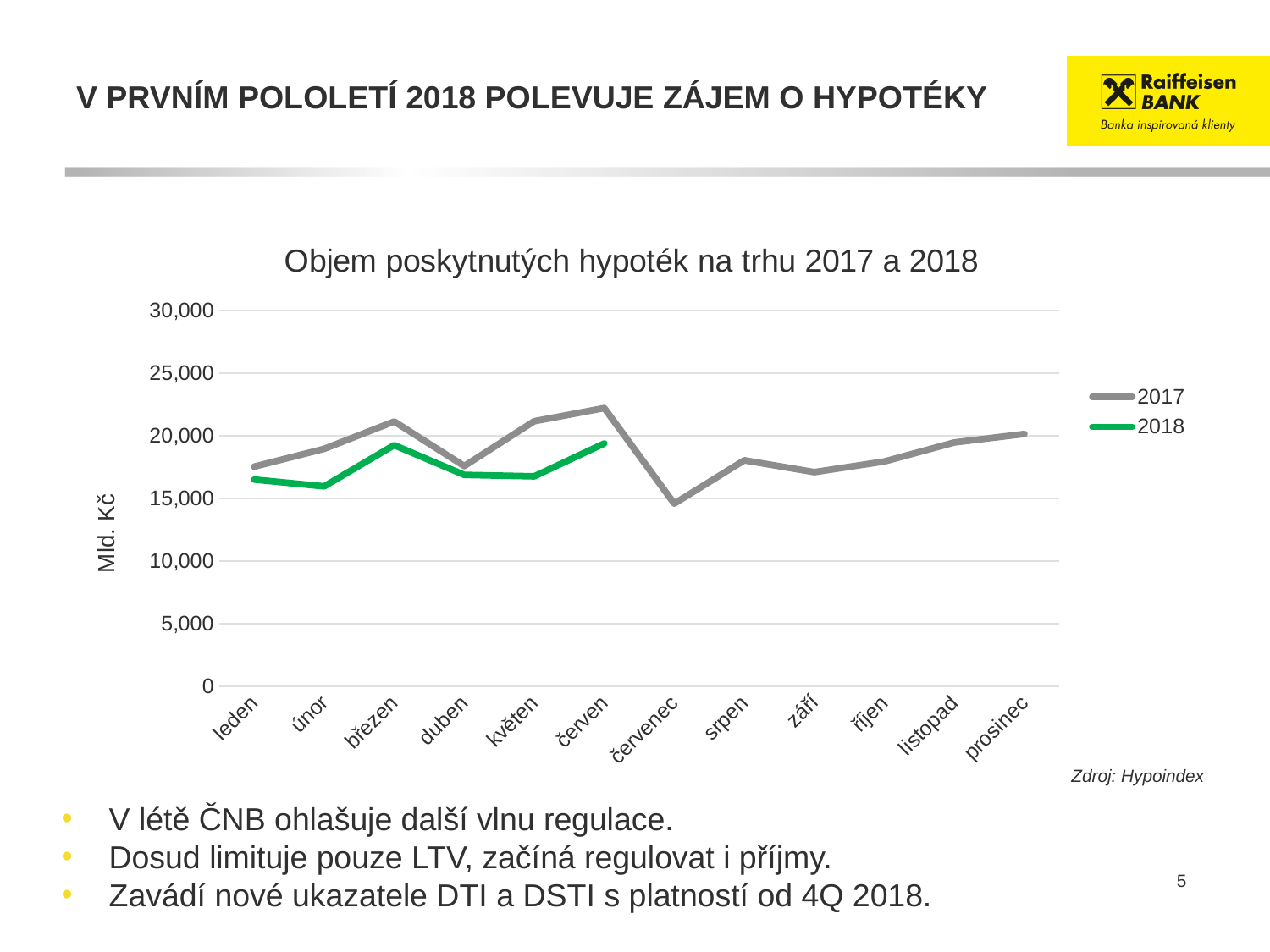
What is the title of the chart? Objem poskytnutých hypoték na trhu 2017 a 2018 Is the value for 2017 in červenec greater or less than 15,000? less Does the 2017 series rise or fall from červen to červenec? fall Which month has the highest value for the 2017 series? červen What kind of chart is shown on the slide? line chart How many months are shown on the x axis? 12 Which month has the lowest value for the 2017 series? červenec Is the value for 2018 in únor greater or less than 20,000? less Is the value for 2017 in červen greater or less than 20,000? greater What colour is the line for the 2018 series? green In leden, which series has the larger value, 2017 or 2018? 2017 How many series does the legend list? 2